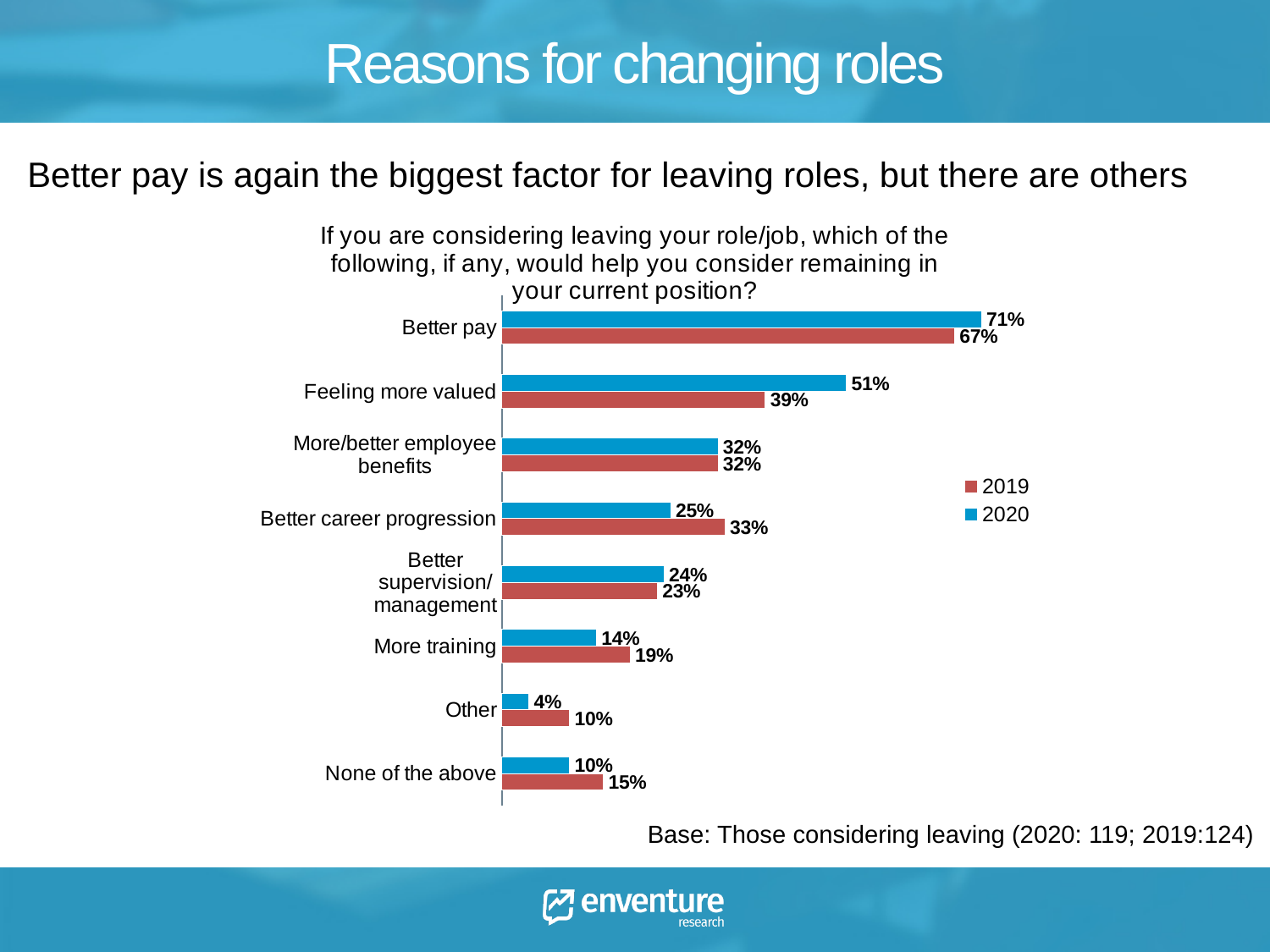
Which colour represents the 2020 series in the legend? Blue What is the 2019 value for Feeling more valued? 39% Which category has the highest 2020 value? Better pay What is the 2019 value for Better career progression? 33% What is the difference between the 2020 and 2019 values for Feeling more valued? 12% What kind of chart is shown on the slide? Bar chart Which category has the lowest 2020 value? Other Which is larger for More training, the 2019 value or the 2020 value? 2019 What is the 2020 value for Better pay? 71% What is the difference between the 2019 and 2020 values for Other? 6% How many series does the legend list? 2 How many categories are shown on the chart? 8